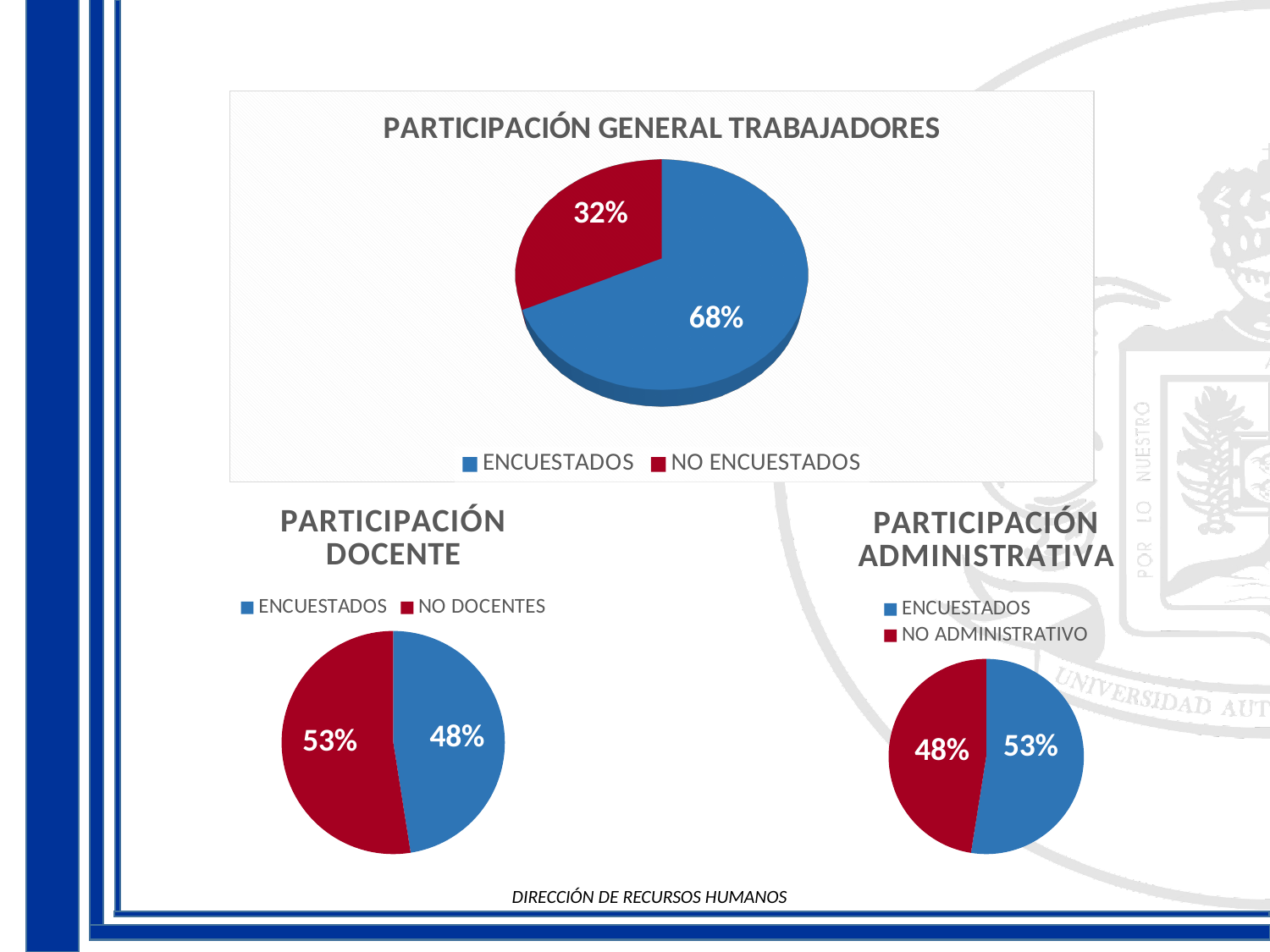
How many entries does the legend of the PARTICIPACIÓN DOCENTE chart list? 2 In the PARTICIPACIÓN GENERAL TRABAJADORES chart, which slice is the largest? ENCUESTADOS In the PARTICIPACIÓN ADMINISTRATIVA chart, what share is NO ADMINISTRATIVO? 48% In the PARTICIPACIÓN GENERAL TRABAJADORES chart, what share is NO ENCUESTADOS? 32% In the PARTICIPACIÓN GENERAL TRABAJADORES chart, what is the difference between the ENCUESTADOS and NO ENCUESTADOS shares? 36% In the PARTICIPACIÓN GENERAL TRABAJADORES chart, what share is ENCUESTADOS? 68% In the PARTICIPACIÓN ADMINISTRATIVA chart, which is larger, ENCUESTADOS or NO ADMINISTRATIVO? ENCUESTADOS What kind of chart is PARTICIPACIÓN GENERAL TRABAJADORES? Pie chart In the PARTICIPACIÓN DOCENTE chart, which slice is the smallest? ENCUESTADOS